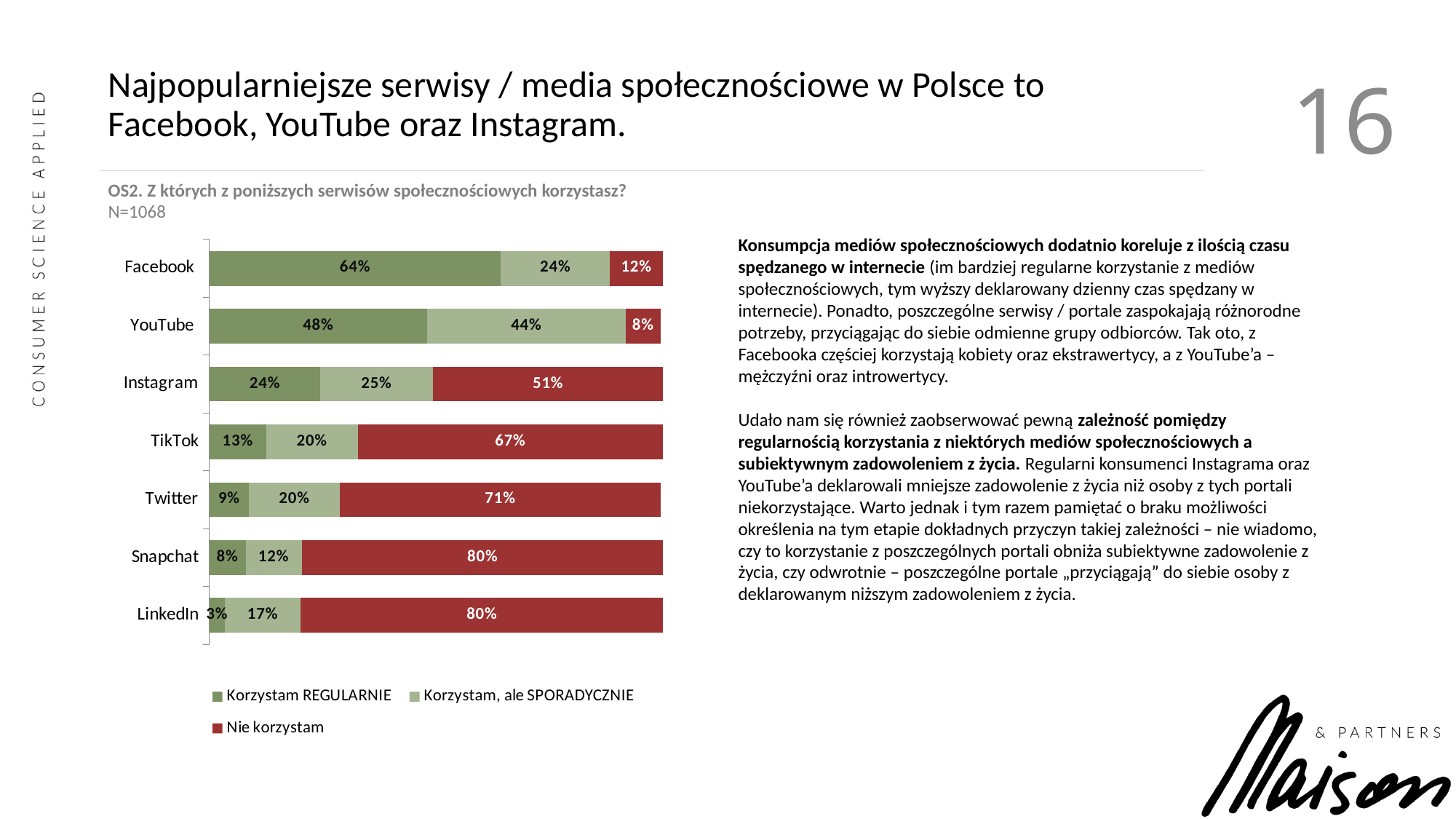
What type of chart is shown on the slide? Stacked bar chart What is the sample size (N) stated above the chart? N=1068 How many series does the legend list? 3 What percentage of respondents use Facebook regularly (Korzystam REGULARNIE)? 64% Which service has the lowest share of regular users (Korzystam REGULARNIE)? LinkedIn Which service has the highest share of regular users (Korzystam REGULARNIE)? Facebook What percentage of respondents use YouTube sporadically (Korzystam, ale SPORADYCZNIE)? 44% What percentage of respondents do not use TikTok (Nie korzystam)? 67% What is the difference between the regular-use percentages for Facebook and YouTube? 16% How many social media services are shown in the chart? 7 What is the combined percentage of regular and sporadic users of Instagram? 49% Which is larger: the share of non-users (Nie korzystam) for Instagram or for Twitter? Twitter